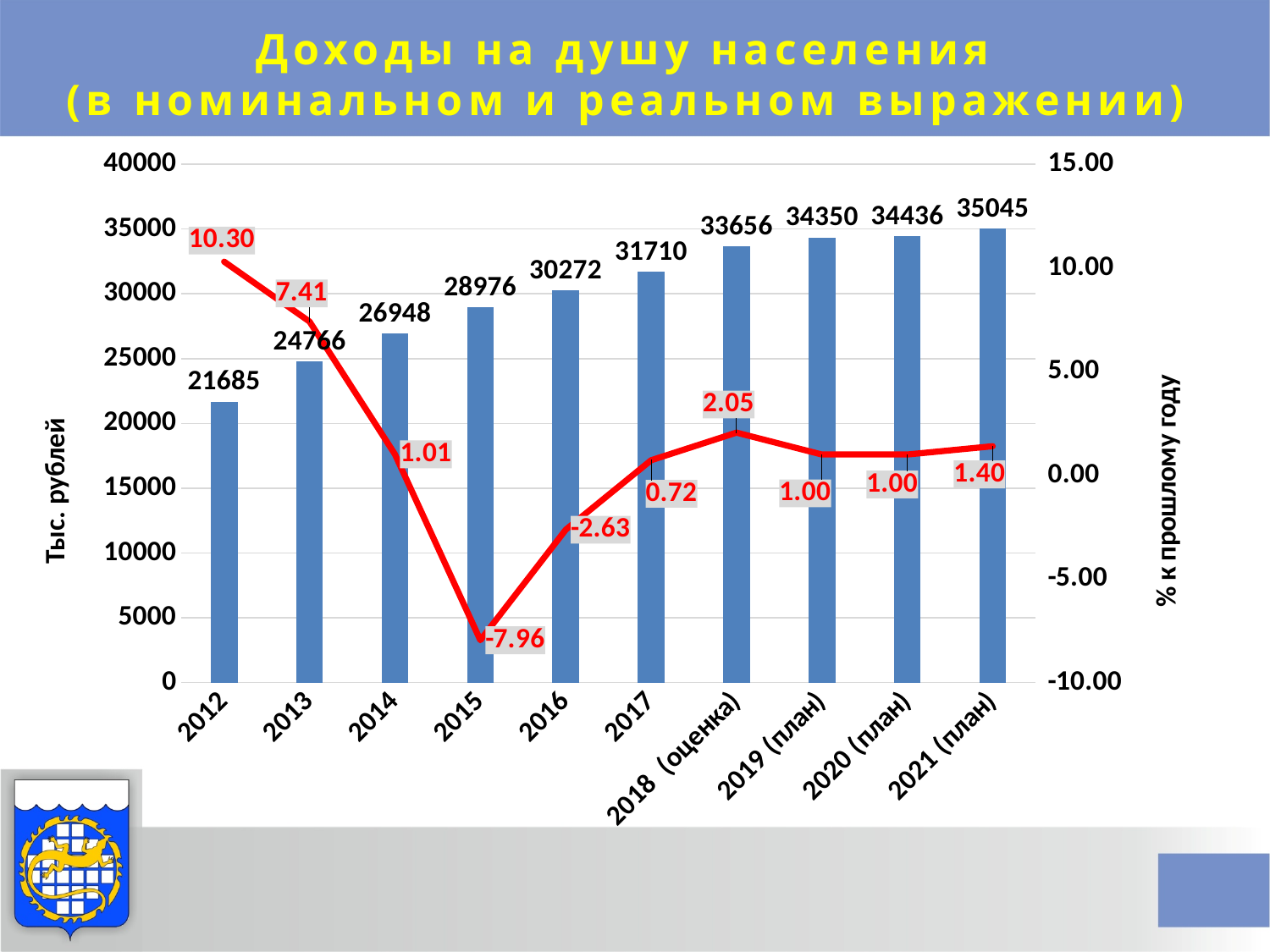
What is the bar value for 2021 (план)? 35045 Is the bar value for 2017 greater or less than 30000? greater What is the difference between the bar values for 2013 and 2012? 3081 Do the bar values rise or fall from 2012 to 2021 (план)? rise What is the value of the red line (% к прошлому году) for 2016? -2.63 What is the title of the left vertical axis? Тыс. рублей What is the bar value for 2015? 28976 Which is larger, the bar value for 2019 (план) or for 2020 (план)? 2020 (план) Which category has the lowest value on the red line? 2015 Which category has the highest bar value? 2021 (план) How many categories are shown on the x axis? 10 What is the value of the red line for 2012? 10.30